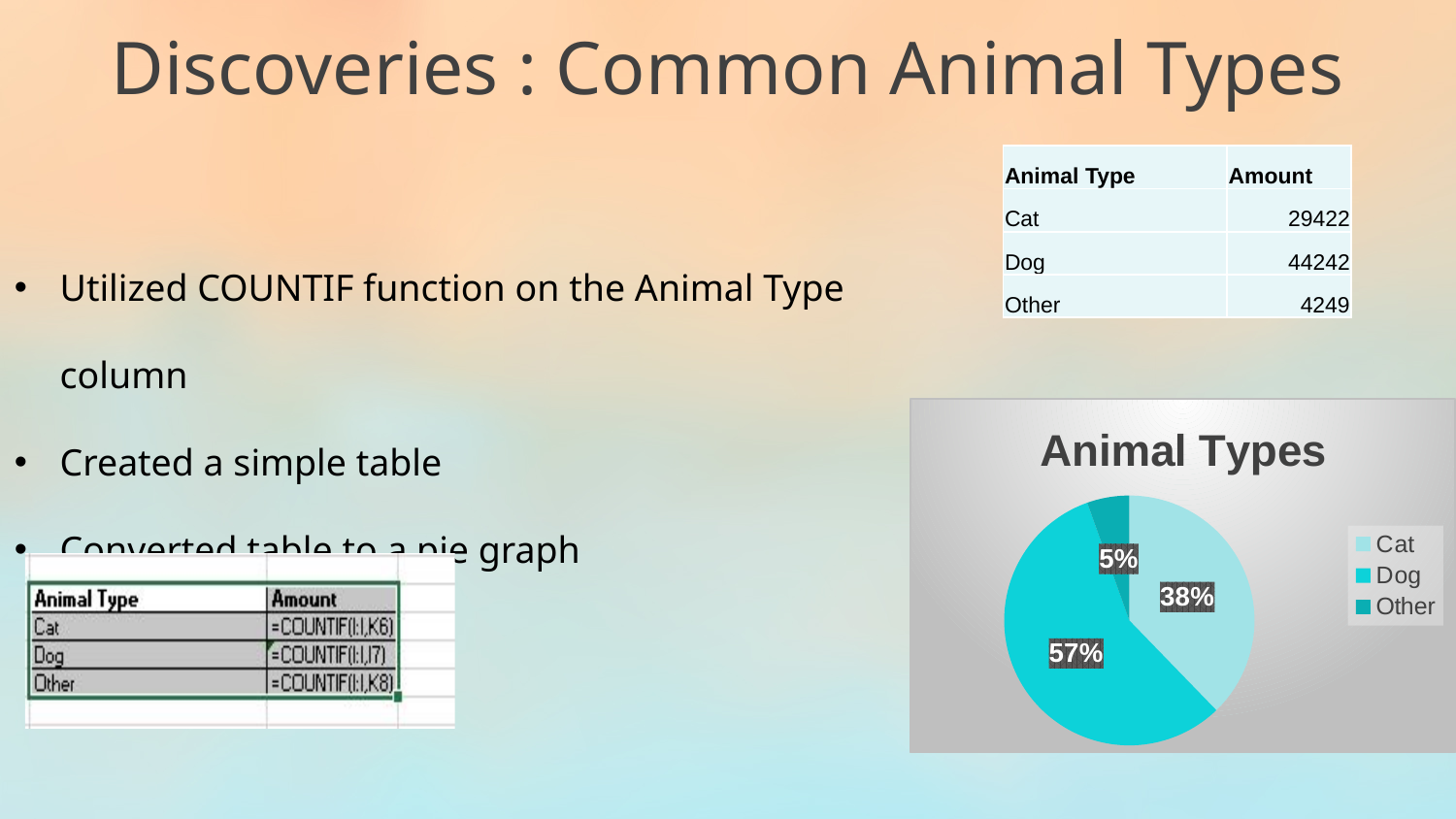
What kind of chart is shown on the slide? pie chart What percentage of the pie does the Cat slice represent? 38% How many slices does the pie chart have? 3 What percentage of the pie does the Other slice represent? 5% Which animal type has the largest slice of the pie? Dog What percentage of the pie does the Dog slice represent? 57% Which legend entry is shown in the darkest teal colour? Other What is the difference in percentage points between the Dog slice and the Cat slice? 19 percentage points How many entries does the chart legend list? 3 What is the title of the chart? Animal Types Which animal type has the smallest slice of the pie? Other Which slice is larger, Cat or Dog? Dog